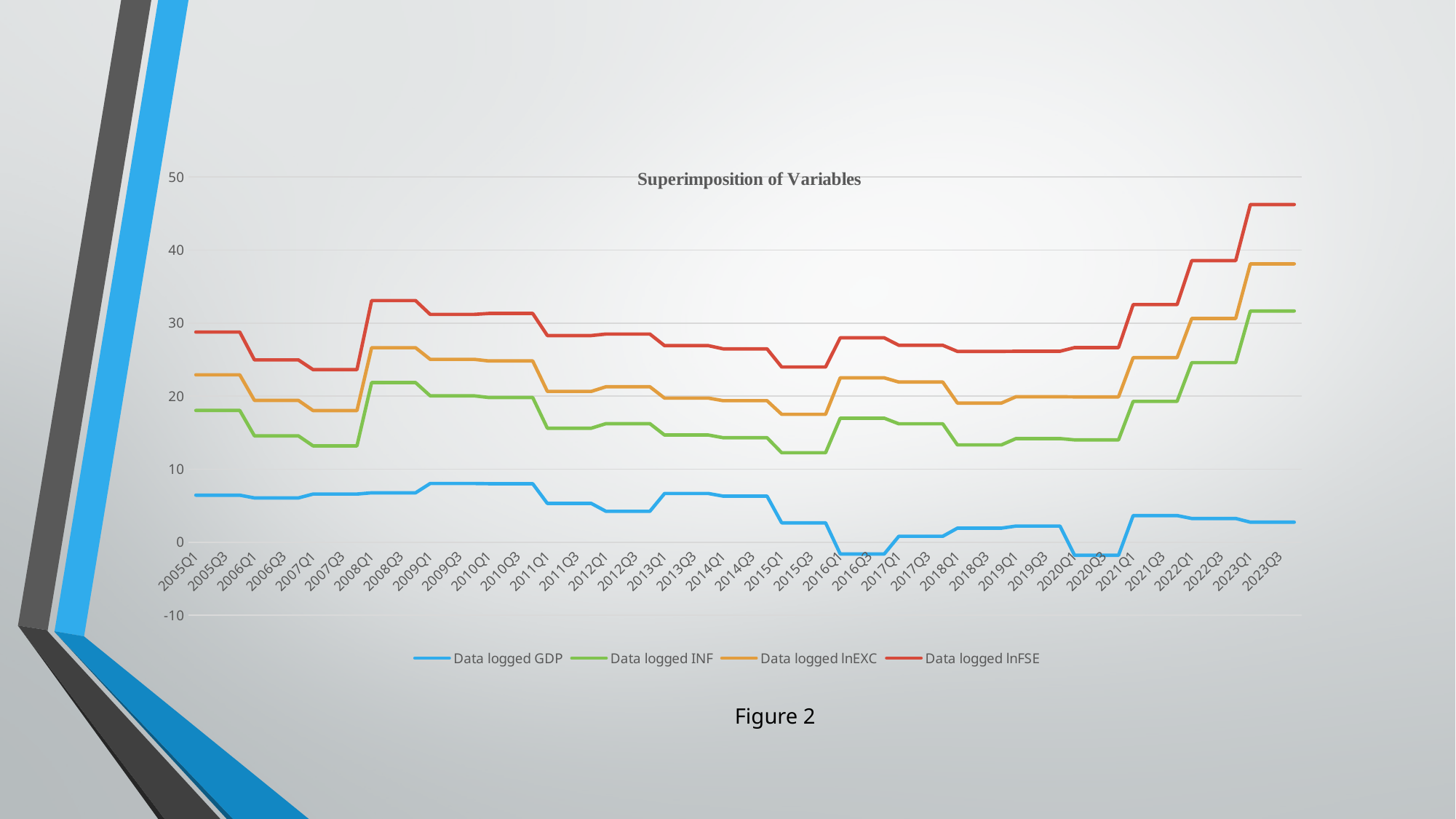
Is the value for Data logged lnFSE at 2023Q3 greater or less than 40? greater Is the value for Data logged GDP at 2009Q1 greater or less than 10? less Which series reaches the highest value on the chart? Data logged lnFSE What kind of chart is shown on the slide? Line chart Is the value for Data logged INF at 2015Q1 greater or less than 20? less What is the title of the chart? Superimposition of Variables Which series stays lowest across the whole period? Data logged GDP How many series does the legend list? 4 At 2008Q1, which is higher: Data logged lnEXC or Data logged INF? Data logged lnEXC Does the Data logged lnFSE line rise or fall from 2021Q1 to 2023Q3? Rise Which colour is used for the Data logged GDP line? Blue